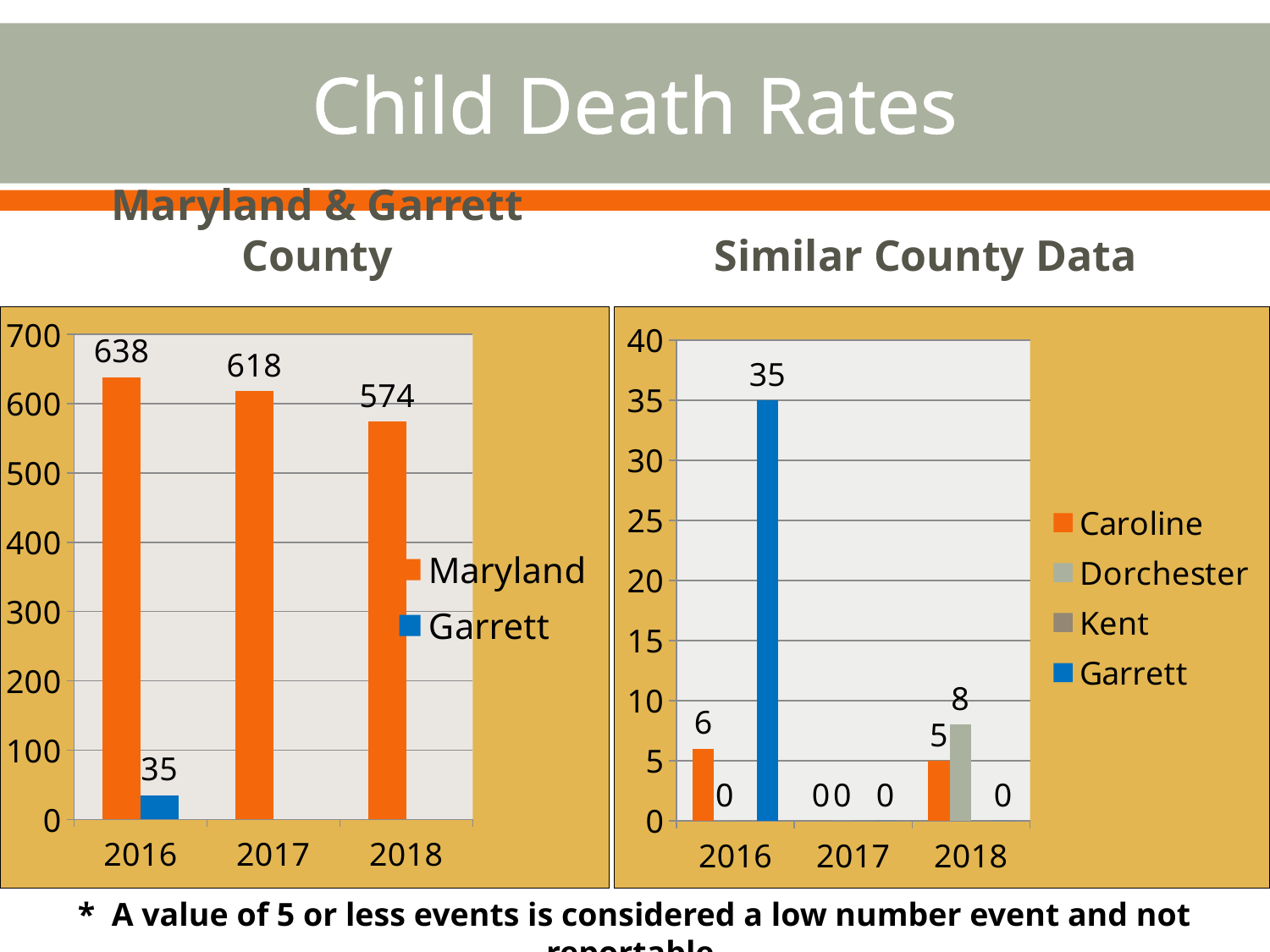
In the Similar County Data chart, what is the value for Dorchester in 2018? 8 In the Similar County Data chart, what is the value for Garrett in 2016? 35 In the Similar County Data chart, what is the value for Caroline in 2016? 6 In the Maryland & Garrett County chart, what is the value for Maryland in 2016? 638 In the Maryland & Garrett County chart, how many years are shown on the x axis? 3 In the Maryland & Garrett County chart, do the Maryland values rise or fall from 2016 to 2018? fall What kind of chart is the Similar County Data chart? bar chart In the Maryland & Garrett County chart, what is the value for Maryland in 2018? 574 In the Maryland & Garrett County chart, how many series does the legend list? 2 In the Similar County Data chart, how many series does the legend list? 4 In the Maryland & Garrett County chart, what is the difference between the Maryland values for 2016 and 2018? 64 In the Maryland & Garrett County chart, what is the value for Garrett in 2016? 35